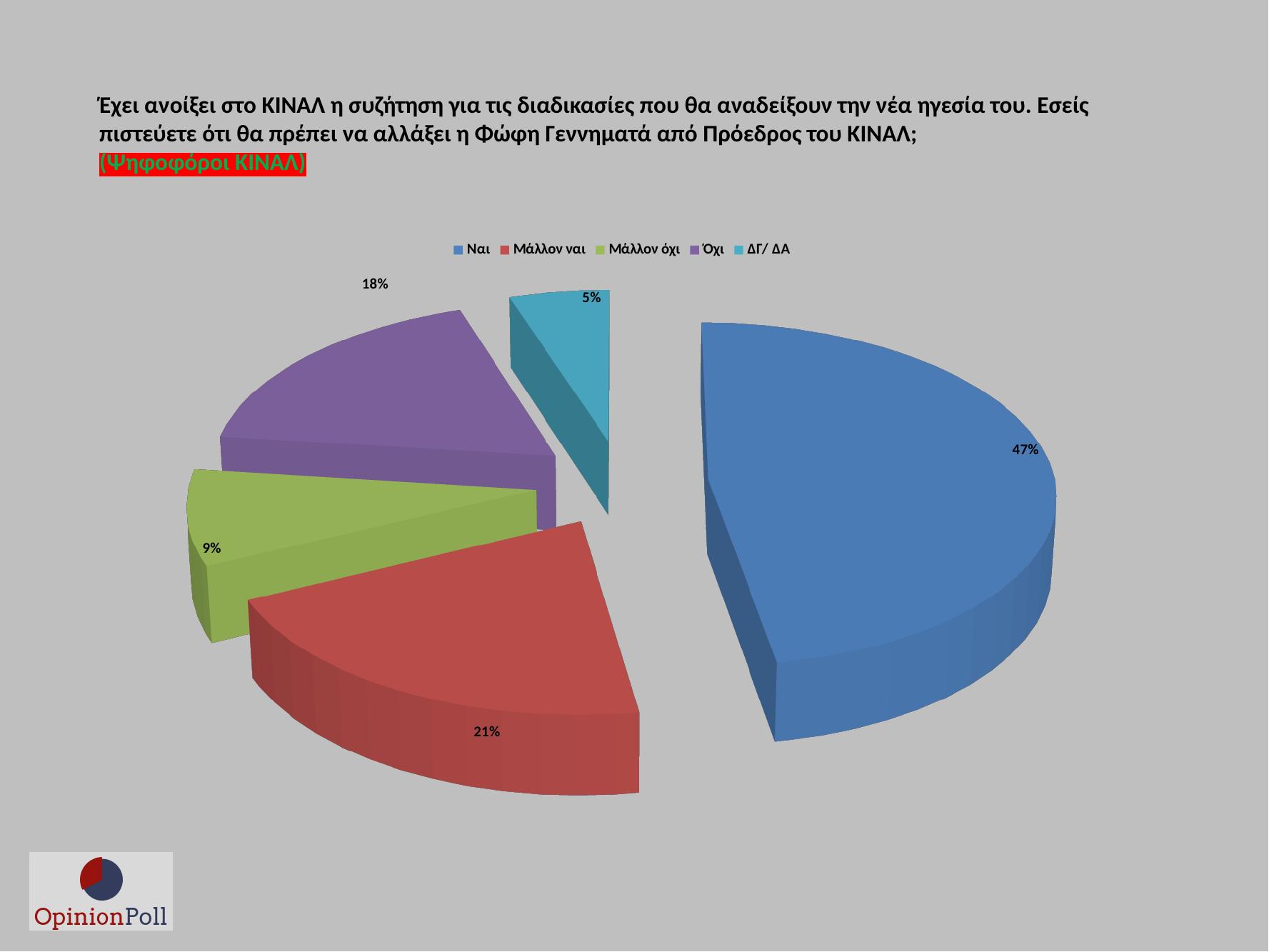
How many slices does the pie chart have? 5 What percentage is shown for "Μάλλον ναι"? 21% What is the difference in percentage points between "Ναι" and "Όχι"? 29 What colour is the "Όχι" slice in the pie chart? Purple Which is larger, the share for "Μάλλον ναι" or the share for "Όχι"? Μάλλον ναι Which category has the largest share of the pie? Ναι What percentage is shown for "ΔΓ/ ΔΑ"? 5% What percentage is shown for "Όχι"? 18% What percentage is shown for "Μάλλον όχι"? 9% What percentage of the pie chart is the "Ναι" slice? 47% Which category has the smallest share of the pie? ΔΓ/ ΔΑ What type of chart is shown on the slide? Pie chart